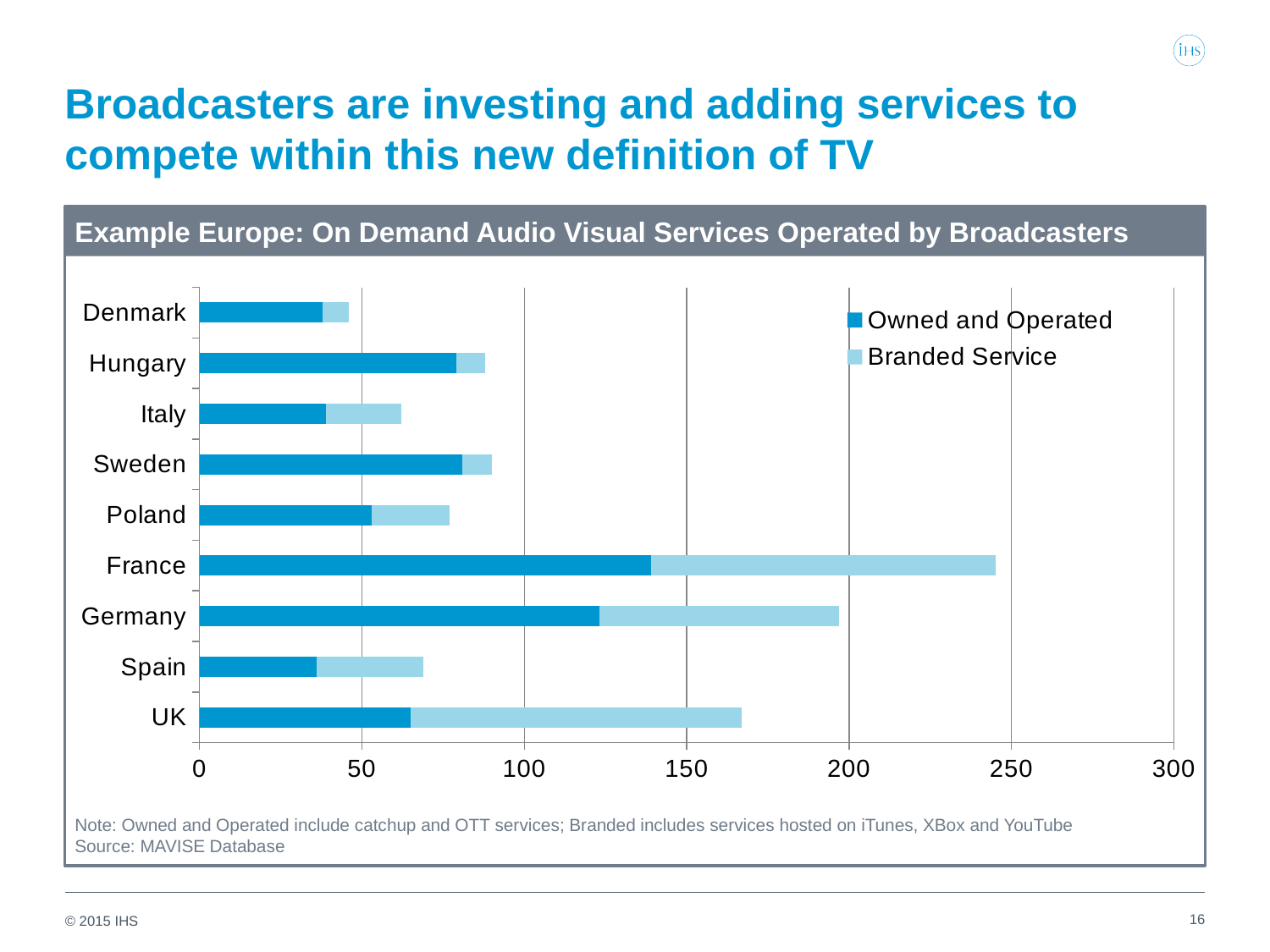
What is the title of the chart? Example Europe: On Demand Audio Visual Services Operated by Broadcasters Which country has the lowest total number of on demand services? Denmark How many series does the legend list? 2 Which country has the highest Owned and Operated value? France Which country has the highest total number of on demand services? France Is the total value for France greater or less than 200? greater What kind of chart is shown on the slide? Stacked bar chart Which has a larger total, Hungary or Italy? Hungary How many countries are shown on the chart? 9 Is the total value for UK greater or less than 150? greater Is the total value for Denmark greater or less than 50? less